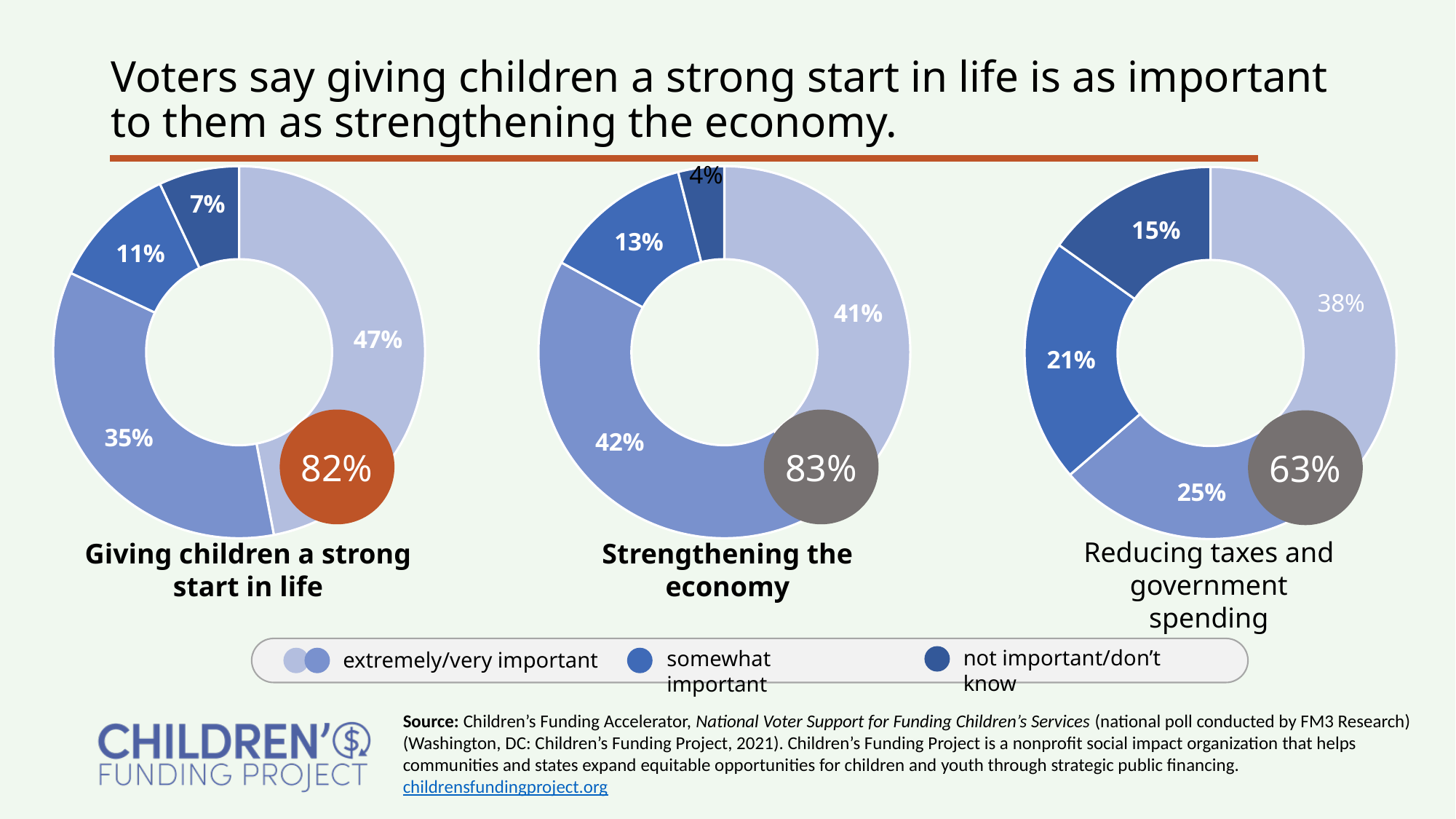
Is the not important/don't know slice larger in the "Reducing taxes and government spending" chart or the "Strengthening the economy" chart? Reducing taxes and government spending What kind of chart is used to show the voter responses on this slide? Donut (pie) chart In the "Reducing taxes and government spending" chart, what percentage is shown in the large circle for extremely/very important combined? 63% What is the difference between the combined extremely/very important percentages for "Strengthening the economy" and "Reducing taxes and government spending"? 20% How many donut charts are shown on the slide? 3 In the "Strengthening the economy" chart, what percentage is labelled for the somewhat important slice? 13% Which of the three charts has the largest combined extremely/very important percentage? Strengthening the economy Which of the three charts has the smallest combined extremely/very important percentage? Reducing taxes and government spending In the "Giving children a strong start in life" chart, what percentage is labelled for the not important/don't know slice? 7% In the "Giving children a strong start in life" chart, what percentage is shown in the large circle for extremely/very important combined? 82% In the "Reducing taxes and government spending" chart, what percentage is labelled for the not important/don't know slice? 15% In the "Strengthening the economy" chart, what percentage is shown in the large circle for extremely/very important combined? 83%